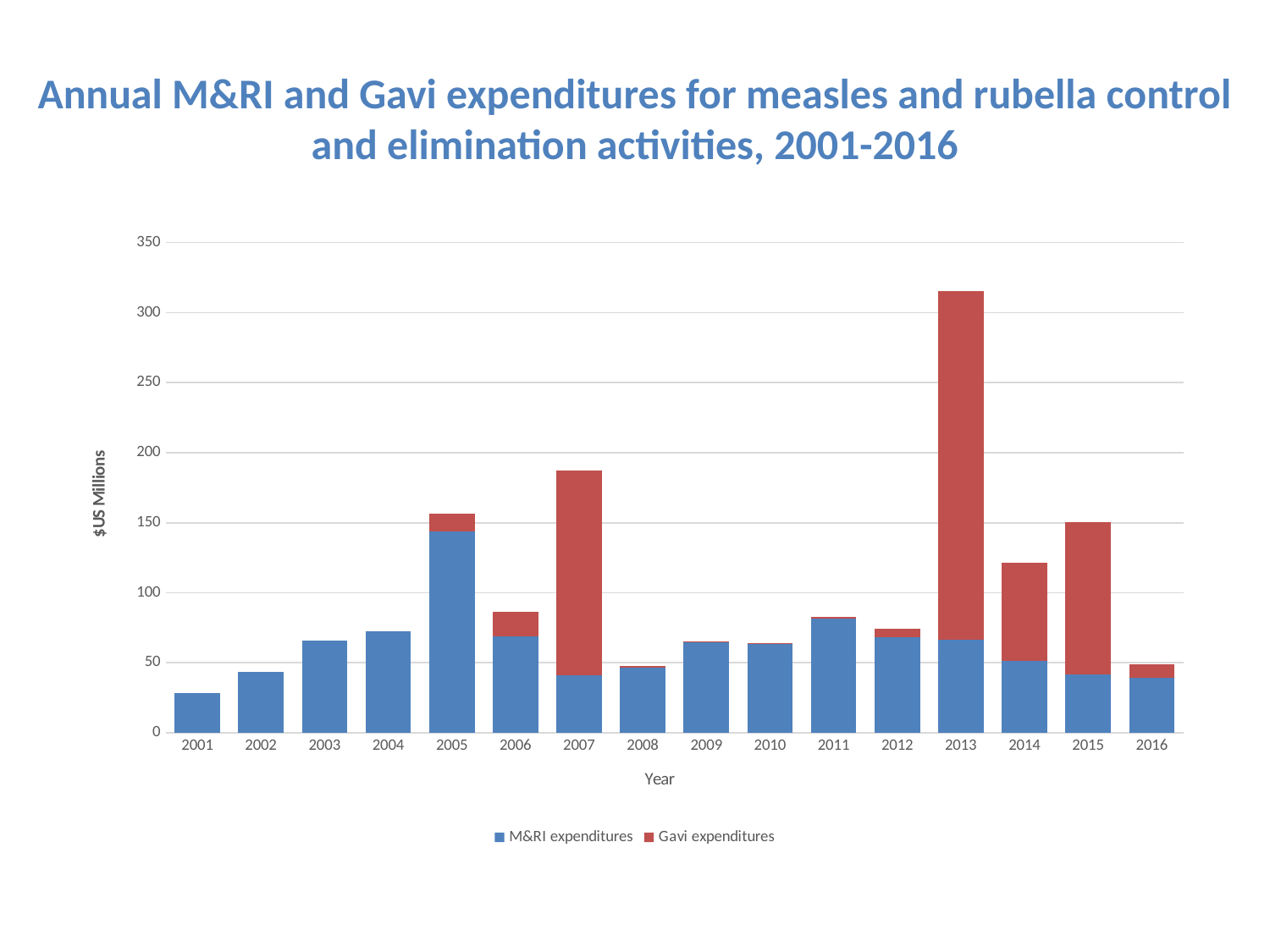
Is the total expenditure for 2007 greater or less than 150? greater What kind of chart is shown on the slide? bar chart Which year has larger M&RI expenditures, 2005 or 2013? 2005 Which year has the larger total expenditure, 2007 or 2015? 2007 Is the total expenditure for 2013 greater or less than 300? greater Which year has the lowest total expenditure? 2001 How many years are shown on the x axis? 16 Which year has the highest M&RI expenditures? 2005 How many series does the legend list? 2 What is the label on the y axis? $US Millions Is the total expenditure for 2001 greater or less than 50? less Which year has the highest total expenditure? 2013